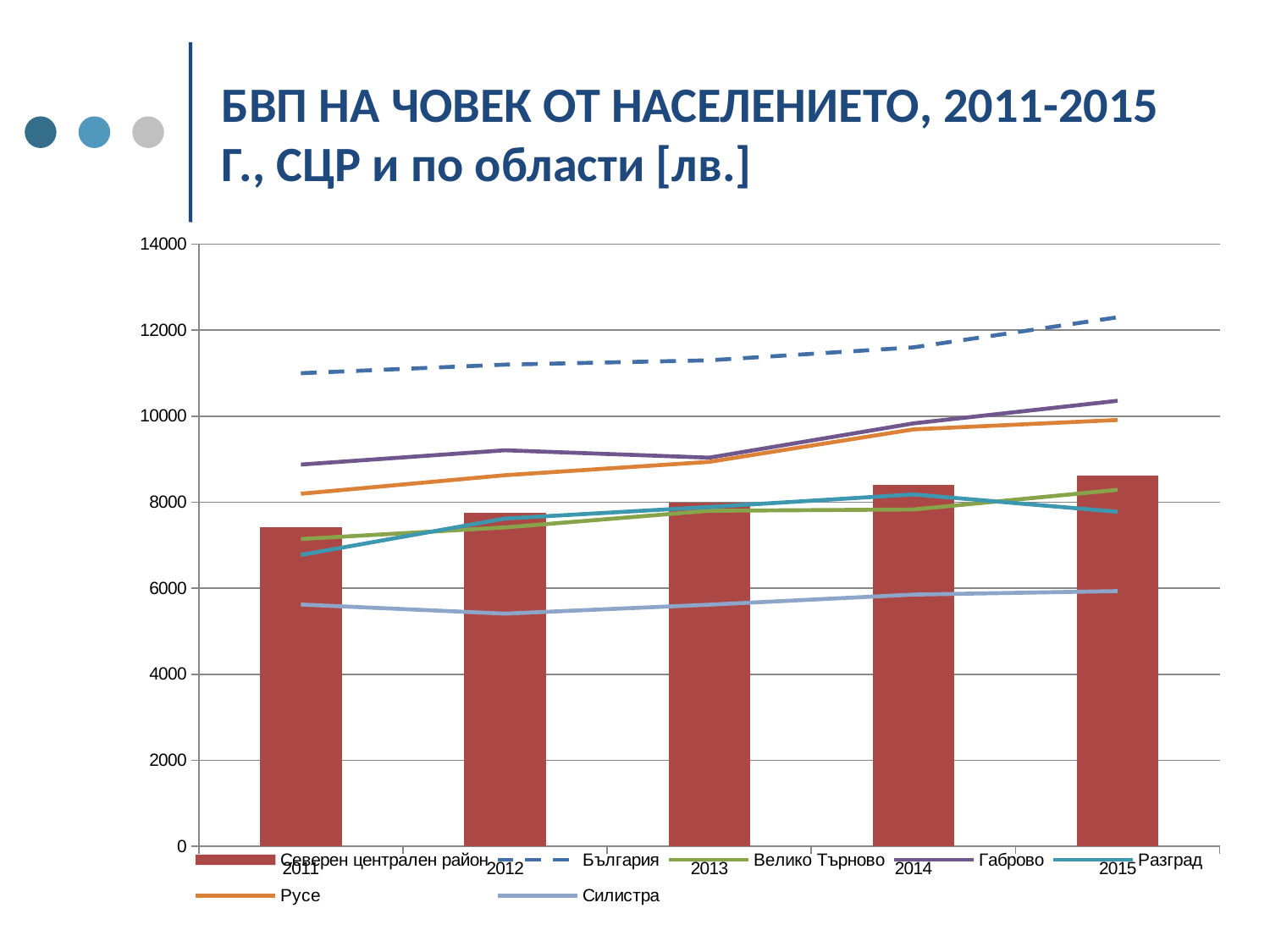
Does the value for България rise or fall from 2011 to 2015? Rises Which series has the highest value in 2015? България Is the value for Северен централен район in 2011 greater or less than 8000? less Which series is drawn as a dashed line? България Is the value for България in 2015 greater or less than 12000? greater How many years are shown on the x axis? 5 In 2015, which is larger: Габрово or Русе? Габрово What kind of chart is shown on the slide? A combination bar and line chart In 2011, which is larger: Велико Търново or Разград? Велико Търново Is the value for Силистра in 2012 greater or less than 6000? less How many series does the legend list? 7 Which series has the lowest values across all years? Силистра